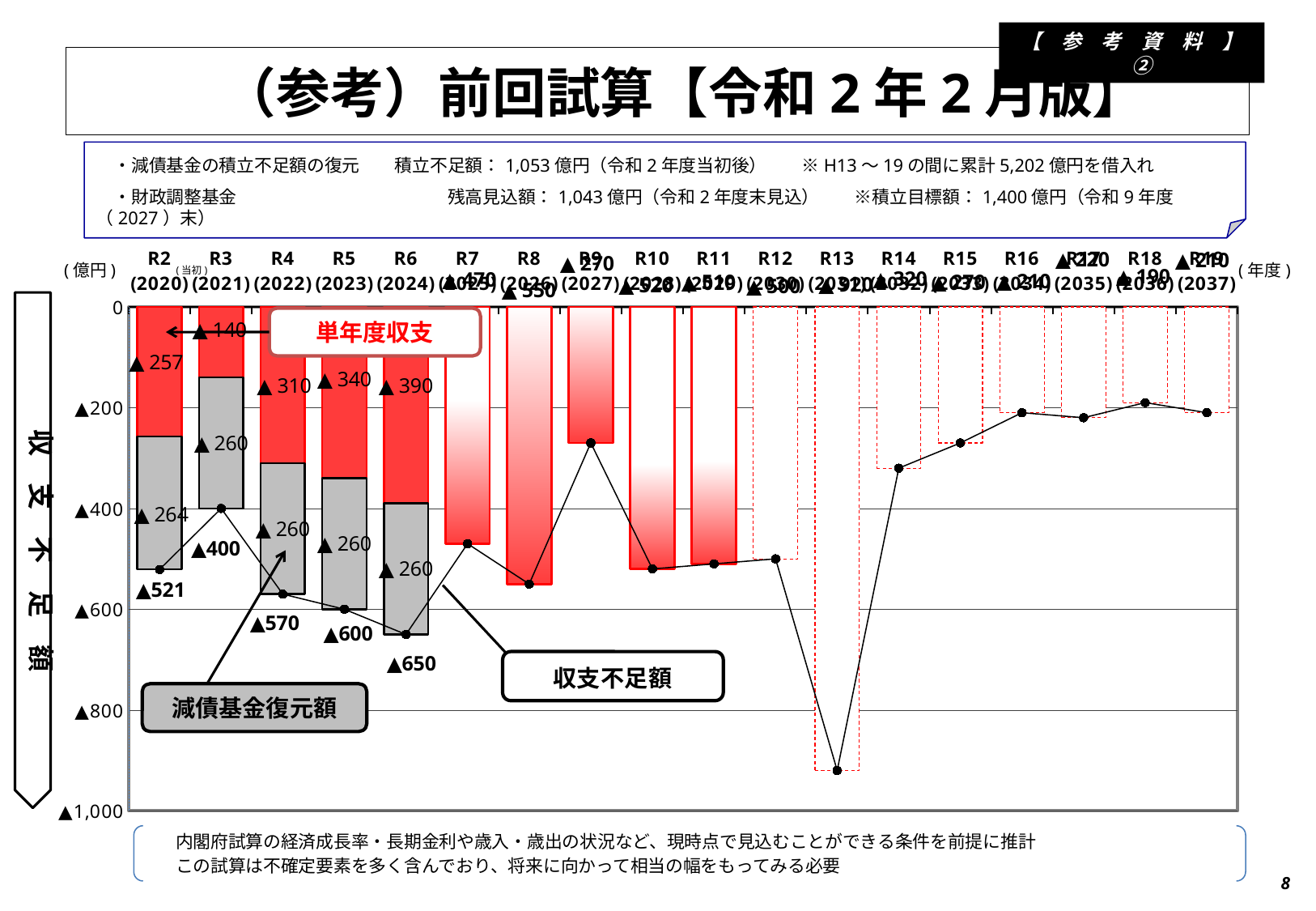
What is the difference between the 単年度収支 values for R2 (2020) and R3 (2021)? 117 From R2 (2020) to R6 (2024), does the total 収支不足額 increase or decrease? Increase What kind of chart is shown on the slide? Bar chart with a line What is the total 収支不足額 shown for R6 (2024)? ▲650 Which year has the largest 収支不足額 on the chart? R13 (2031) What is the 単年度収支 value shown for R2 (2020)? ▲257 Which has the larger total 収支不足額, R4 (2022) or R5 (2023)? R5 (2023) How many fiscal years are shown on the x axis of the chart? 18 What is the 減債基金復元額 value shown for R4 (2022)? ▲260 What is the total 収支不足額 shown for R3 (2021)? ▲400 Which colour represents 減債基金復元額 in the bars? Gray Is the 収支不足額 for R13 (2031) greater or less than 800 in magnitude? greater